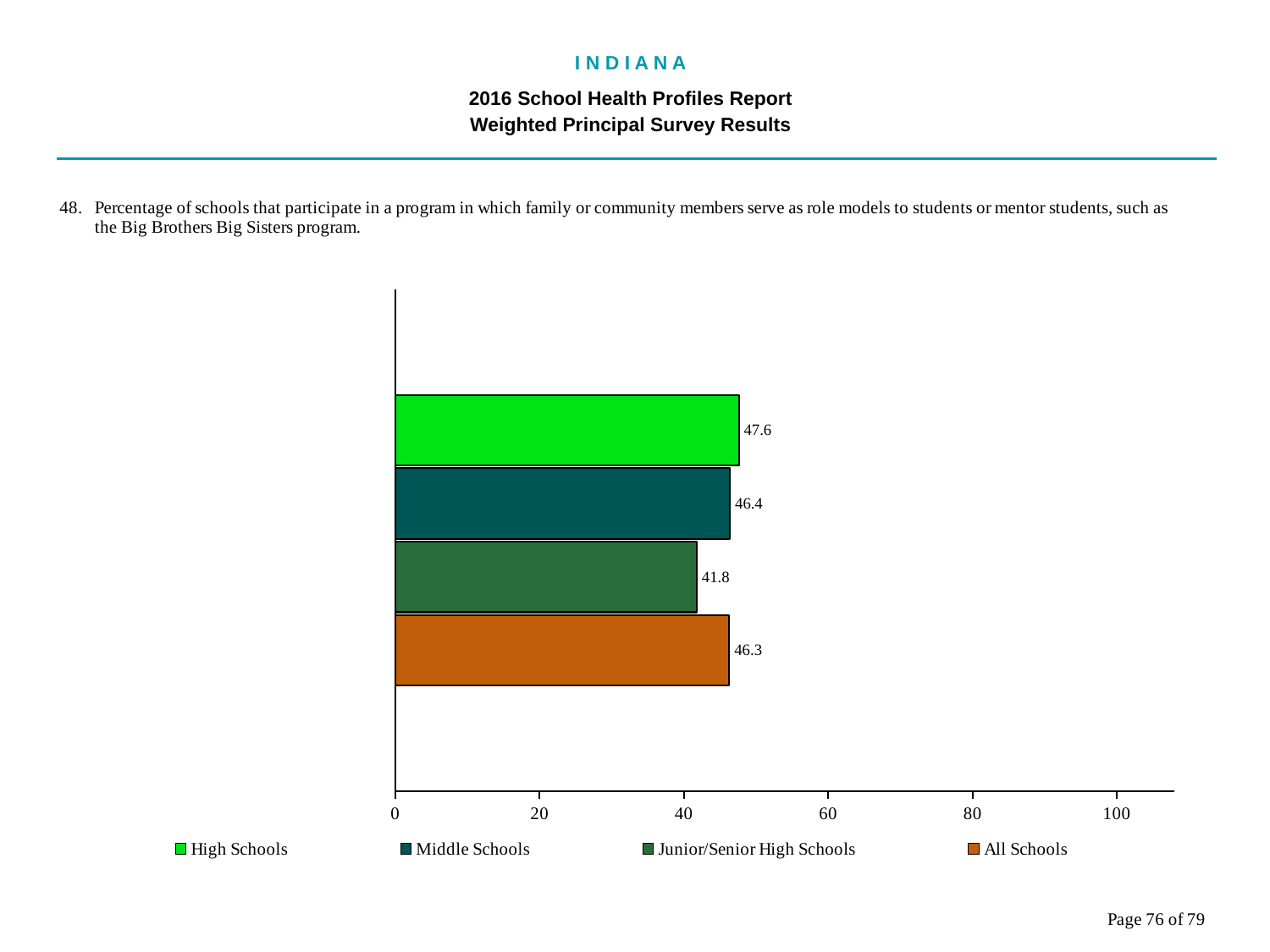
What is the value for High Schools? 47.6 What is the difference between the Middle Schools value and the All Schools value? 0.1 What is the difference between the High Schools value and the Junior/Senior High Schools value? 5.8 What is the value for Middle Schools? 46.4 Which school type has the highest value? High Schools Is the value for Junior/Senior High Schools greater or less than 40? greater How many bars are shown in the chart? 4 What is the value for All Schools? 46.3 Which school type has the lowest value? Junior/Senior High Schools What kind of chart is shown on the slide? Bar chart What is the value for Junior/Senior High Schools? 41.8 How many entries does the legend list? 4